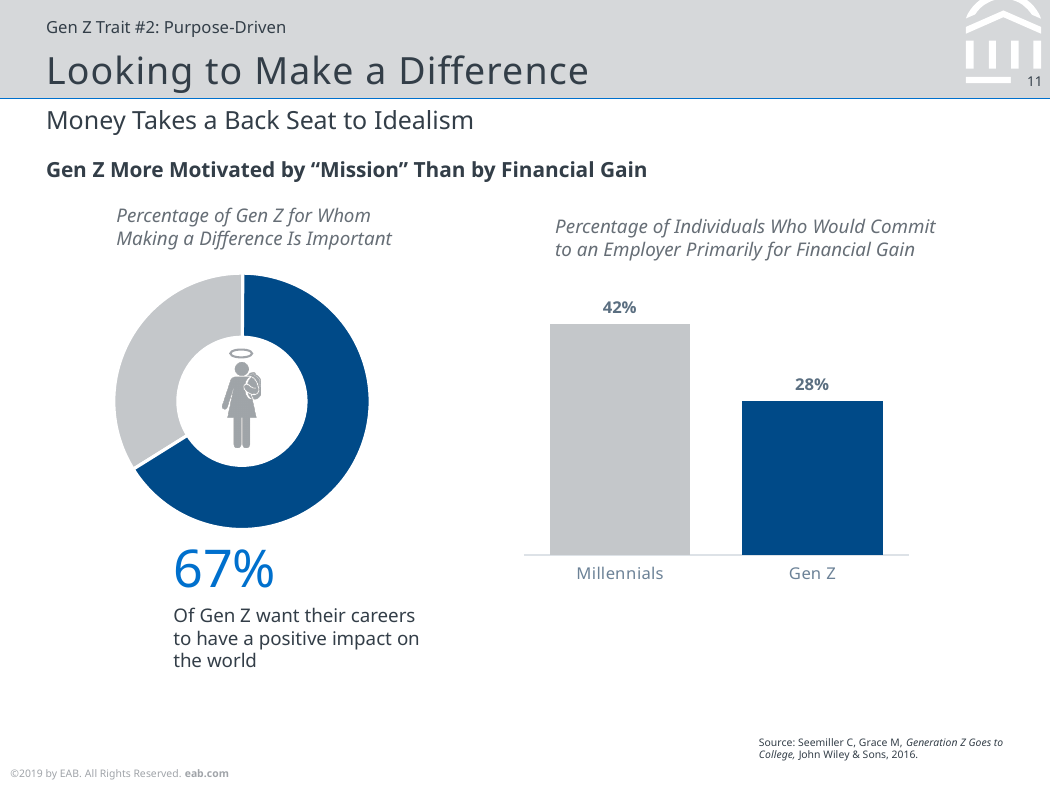
In the bar chart on the right, what is the difference between the Millennials and Gen Z values? 14% What is the title of the bar chart on the right? Percentage of Individuals Who Would Commit to an Employer Primarily for Financial Gain What is the title of the donut chart on the left? Percentage of Gen Z for Whom Making a Difference Is Important In the donut chart on the left, what percentage of Gen Z want their careers to have a positive impact on the world? 67% In the bar chart on the right, is the value for Millennials or Gen Z larger? Millennials In the bar chart on the right, which category has the highest value? Millennials What kind of chart is the chart on the right of the slide? Bar chart How many categories are shown in the bar chart on the right? 2 In the bar chart on the right, which category has the lowest value? Gen Z In the bar chart on the right, what is the value for Gen Z? 28% In the bar chart on the right, what is the value for Millennials? 42% What kind of chart is the chart on the left of the slide? Donut chart